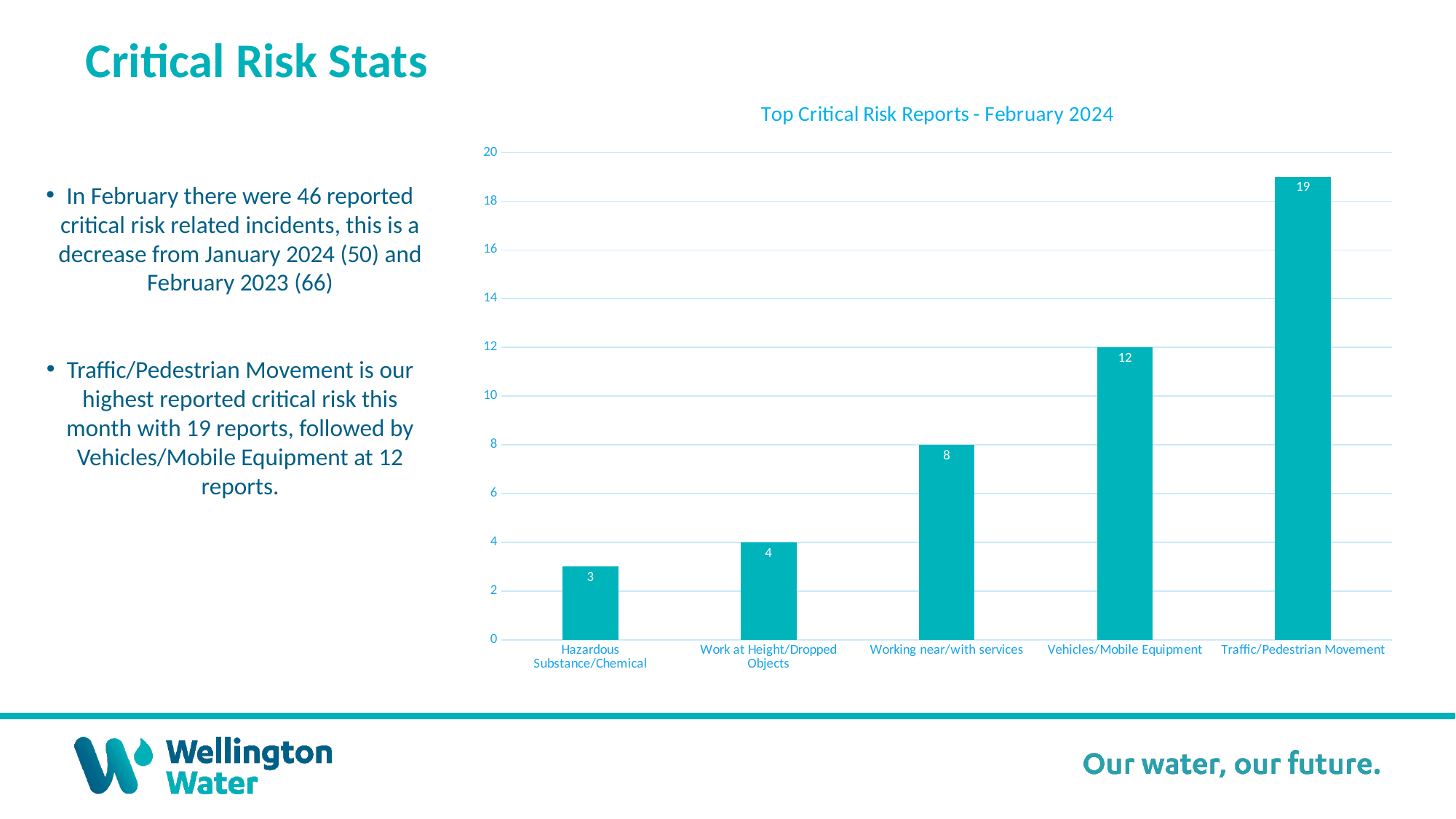
How many categories are shown on the x axis? 5 Is the value for Vehicles/Mobile Equipment greater or less than 10? greater What kind of chart is shown on the slide? bar chart What is the title of the chart? Top Critical Risk Reports - February 2024 What is the difference between the values for Traffic/Pedestrian Movement and Vehicles/Mobile Equipment? 7 Which category has the lowest value? Hazardous Substance/Chemical What is the value for Working near/with services? 8 Which is larger, the value for Vehicles/Mobile Equipment or the value for Working near/with services? Vehicles/Mobile Equipment What is the value for Hazardous Substance/Chemical? 3 What is the difference between the values for Working near/with services and Work at Height/Dropped Objects? 4 What is the value for Traffic/Pedestrian Movement? 19 Which category has the highest value? Traffic/Pedestrian Movement